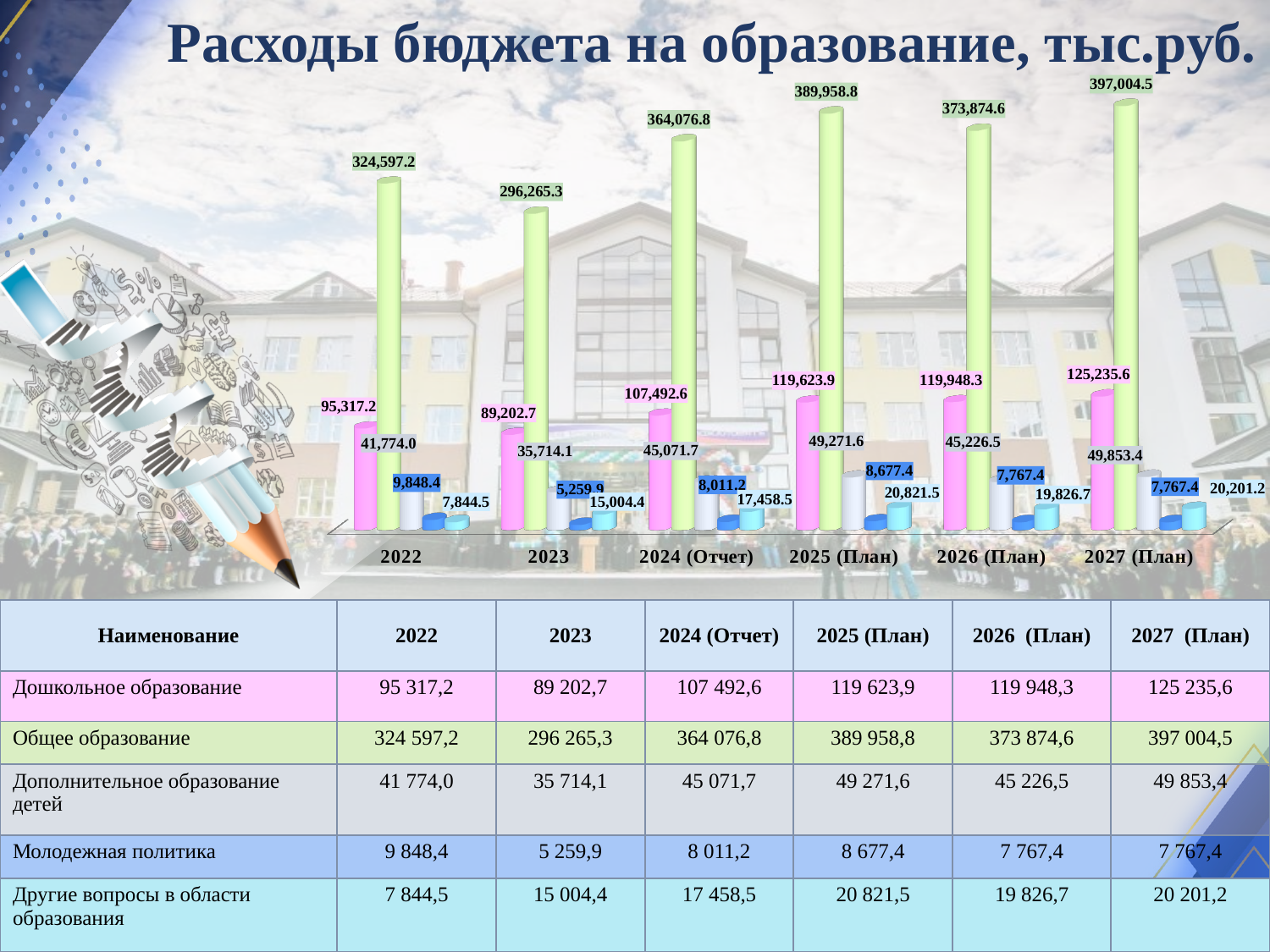
What is the title of the chart? Расходы бюджета на образование, тыс.руб. What is the difference between Общее образование in 2025 (План) and 2024 (Отчет)? 25,882.0 Does the value for Дошкольное образование generally rise or fall from 2023 to 2027 (План)? Rise How many years (categories) are shown on the x axis of the chart? 6 By how much does Дошкольное образование in 2027 (План) exceed its value in 2022? 29,918.4 In which year is the value for Общее образование the highest? 2027 (План) What kind of chart is shown on the slide? Bar chart What is the value for Дошкольное образование in 2027 (План)? 125,235.6 What is the value for Общее образование in 2024 (Отчет)? 364,076.8 What is the value for Другие вопросы в области образования in 2025 (План)? 20,821.5 Which year has the larger value for Молодежная политика, 2022 or 2023? 2022 In which year is the value for Общее образование the lowest? 2023